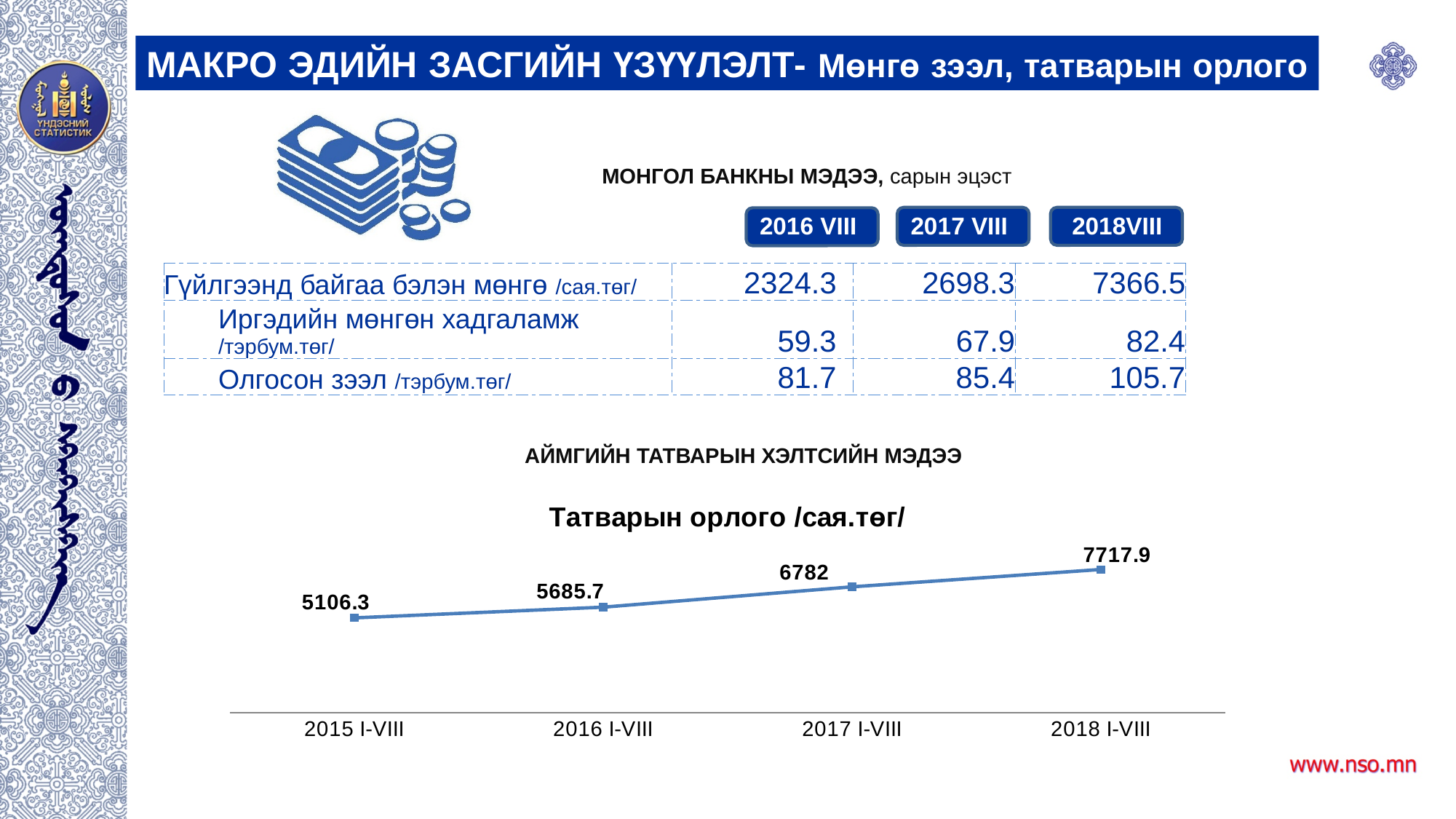
What is the value for 2016 I-VIII in the chart "Татварын орлого /сая.төг/"? 5685.7 In the chart "Татварын орлого /сая.төг/", what is the difference between the values for 2018 I-VIII and 2017 I-VIII? 935.9 What is the value for 2015 I-VIII in the chart "Татварын орлого /сая.төг/"? 5106.3 In the chart "Татварын орлого /сая.төг/", what is the difference between the values for 2016 I-VIII and 2015 I-VIII? 579.4 What kind of chart is "Татварын орлого /сая.төг/"? Line chart What is the value for 2018 I-VIII in the chart "Татварын орлого /сая.төг/"? 7717.9 Do the values in the chart "Татварын орлого /сая.төг/" rise or fall from 2015 I-VIII to 2018 I-VIII? Rise In the chart "Татварын орлого /сая.төг/", which is larger: the value for 2017 I-VIII or 2016 I-VIII? 2017 I-VIII Which period has the lowest value in the chart "Татварын орлого /сая.төг/"? 2015 I-VIII How many data points are plotted in the chart "Татварын орлого /сая.төг/"? 4 What is the value for 2017 I-VIII in the chart "Татварын орлого /сая.төг/"? 6782 Which period has the highest value in the chart "Татварын орлого /сая.төг/"? 2018 I-VIII